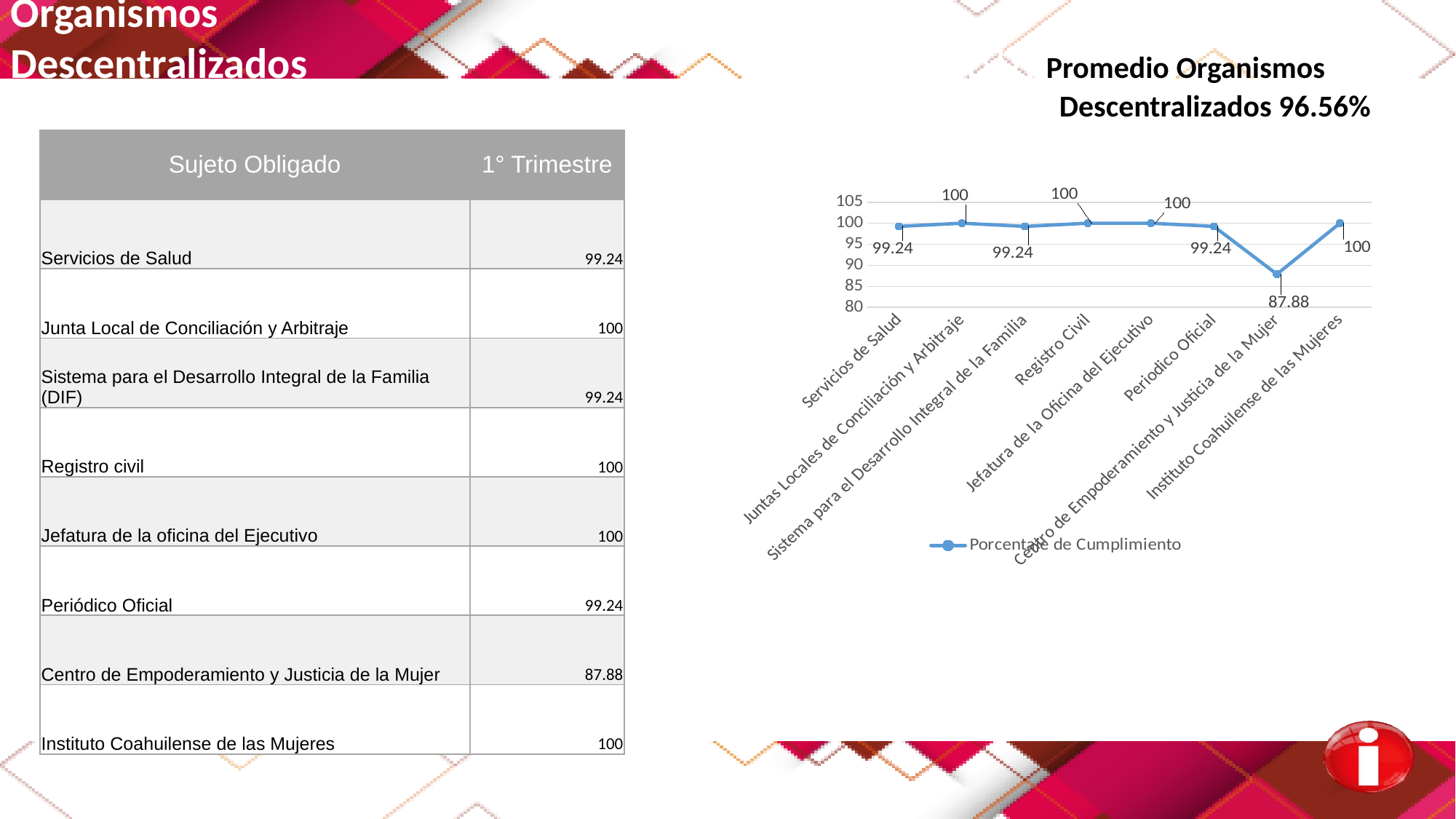
What is the difference between the value for Jefatura de la Oficina del Ejecutivo and the value for Servicios de Salud? 0.76 What is the value for Servicios de Salud in the line chart? 99.24 Which is larger, the value for Instituto Coahuilense de las Mujeres or the value for Centro de Empoderamiento y Justicia de la Mujer? Instituto Coahuilense de las Mujeres What is the difference between the value for Registro Civil and the value for Centro de Empoderamiento y Justicia de la Mujer? 12.12 What is the value for Periodico Oficial in the line chart? 99.24 Which category has the lowest value in the line chart? Centro de Empoderamiento y Justicia de la Mujer What is the value for Registro Civil in the line chart? 100 How many categories are plotted on the x axis of the line chart? 8 What kind of chart is shown on the slide? line chart What is the value for Centro de Empoderamiento y Justicia de la Mujer in the line chart? 87.88 What series name does the legend of the line chart show? Porcentaje de Cumplimiento Is the value for Centro de Empoderamiento y Justicia de la Mujer greater or less than 90? less